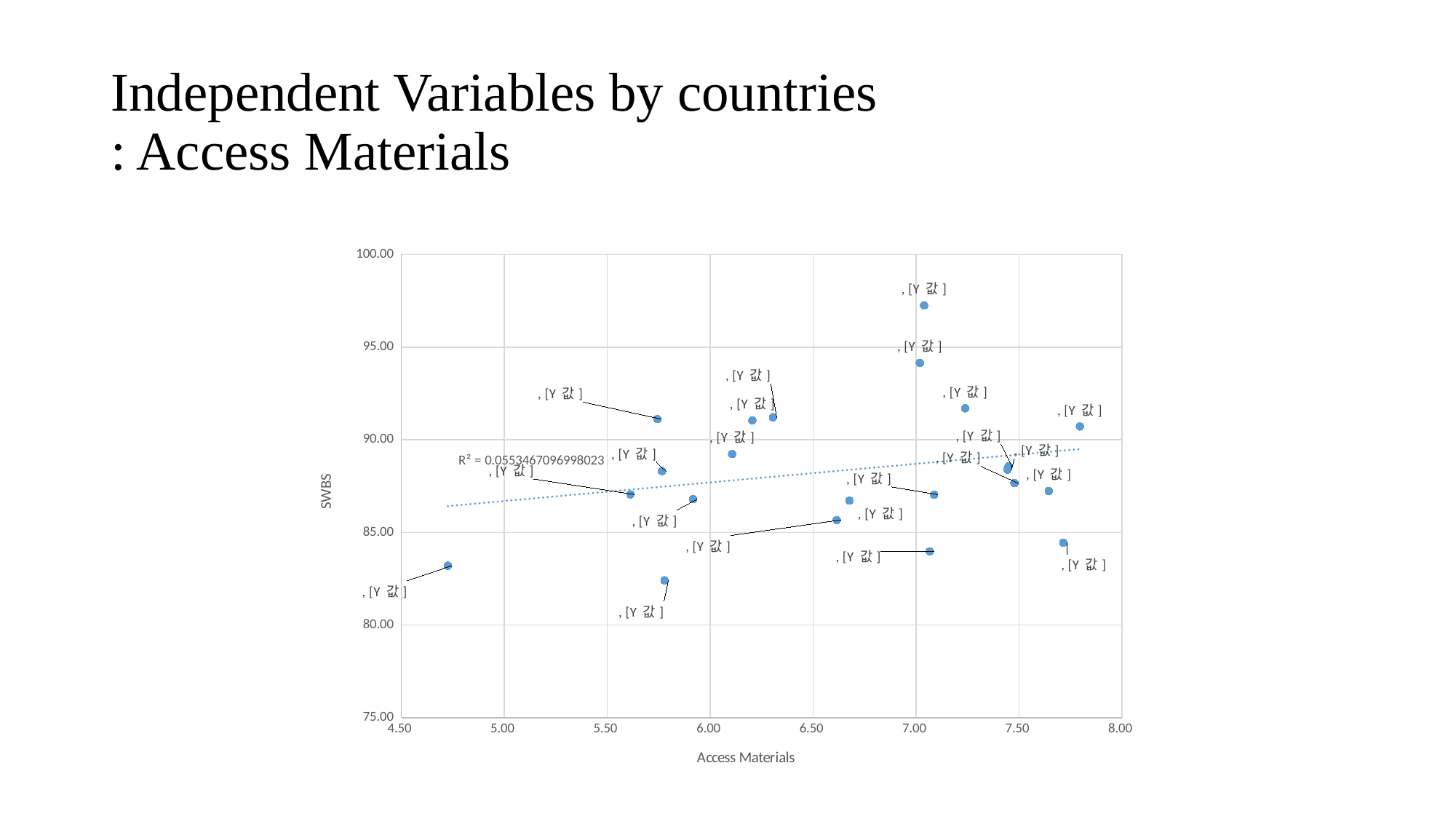
Is the SWBS value of the point with the smallest Access Materials value greater or less than 85.00? less What is the minimum value shown on the horizontal axis? 4.50 What R² value is printed on the chart? R² = 0.0553467096998023 What is the maximum value shown on the vertical axis? 100.00 What kind of chart is shown on the slide? scatter chart Is the Access Materials value of the leftmost point greater or less than 5.00? less Is the SWBS value of the lowest point on the chart greater or less than 85.00? less Does the dotted trendline rise or fall as Access Materials increases? rise What is the title of the horizontal axis of the chart? Access Materials What is the title of the vertical axis of the chart? SWBS